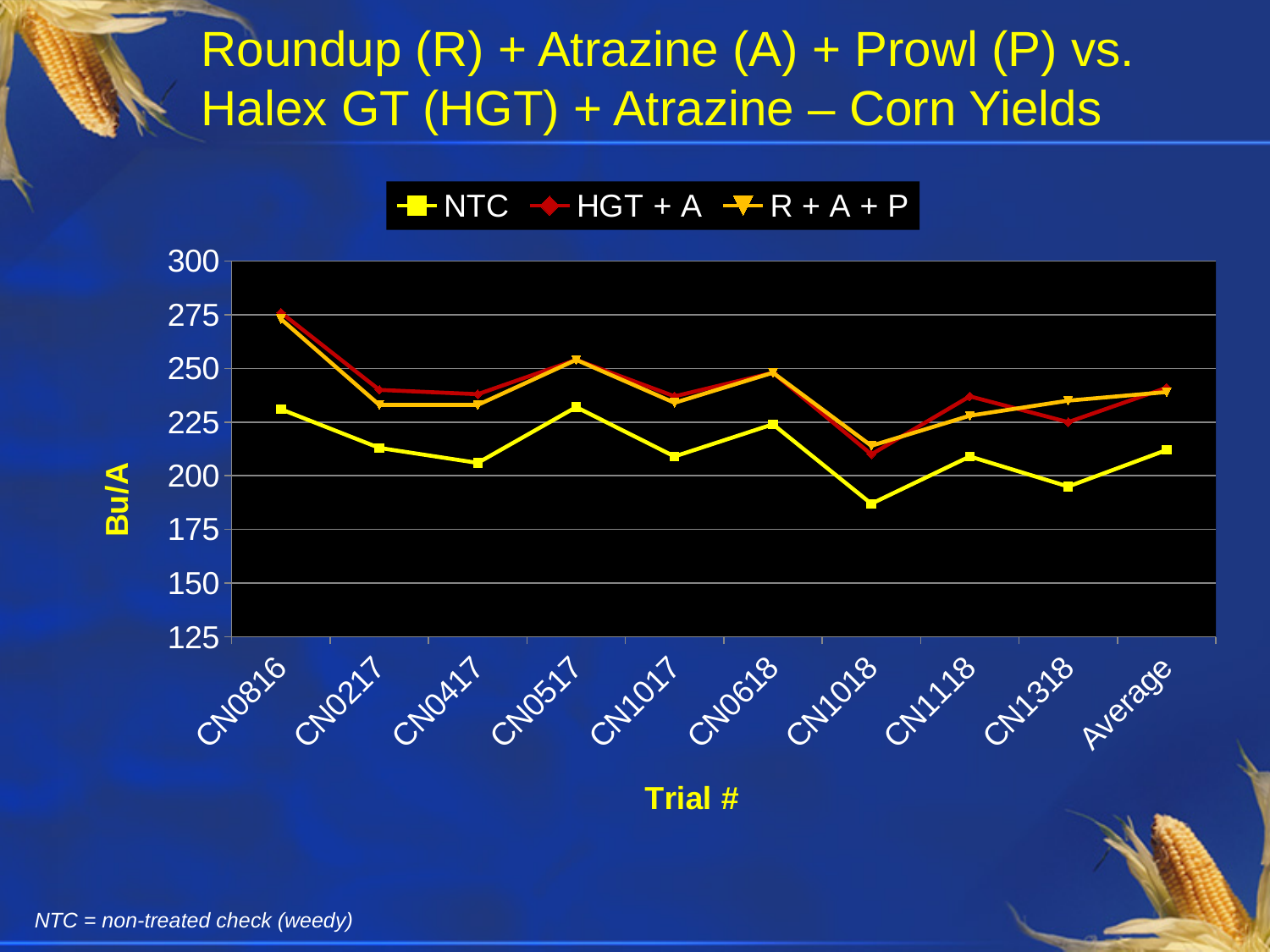
At CN0816, which is larger: NTC or HGT + A? HGT + A For which trial is the NTC series lowest? CN1018 Is the R + A + P value for CN0517 greater or less than 250? greater Is the NTC value for CN1018 greater or less than 200? less What is the label of the y axis? Bu/A What is the title of the x axis? Trial # What kind of chart is shown on the slide? Line chart For which trial is the HGT + A series highest? CN0816 Is the HGT + A value for CN1018 greater or less than 225? less How many series does the legend list? 3 How many categories are shown along the x axis? 10 Does the NTC series rise or fall from CN0816 to CN0217? fall